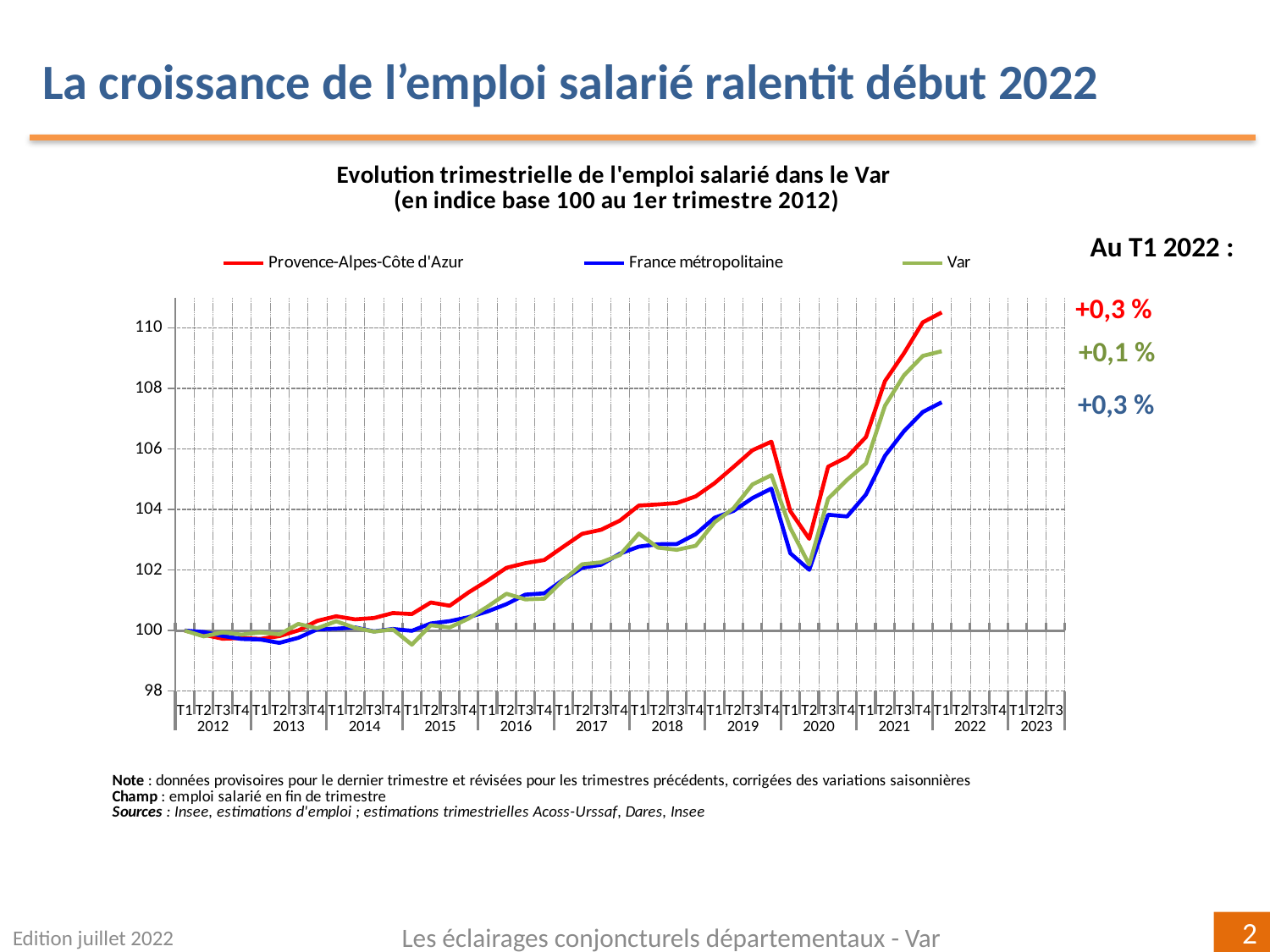
Is the index value for France métropolitaine at T1 2022 greater or less than 108? less What is the index value of all three series at T1 2012? 100 Which series has the highest index value at T1 2022? Provence-Alpes-Côte d'Azur According to the annotation, what is the quarterly change for Provence-Alpes-Côte d'Azur at T1 2022? +0,3 % According to the annotation, what is the quarterly change for France métropolitaine at T1 2022? +0,3 % Which series has the lowest index value at T1 2022? France métropolitaine Overall, do the index values rise or fall between 2012 and T1 2022? rise What is the title of the chart? Evolution trimestrielle de l'emploi salarié dans le Var (en indice base 100 au 1er trimestre 2012) What kind of chart is shown on the slide? line chart How many series does the legend list? 3 According to the annotation, what is the quarterly change for Var at T1 2022? +0,1 % Which series is drawn in red? Provence-Alpes-Côte d'Azur